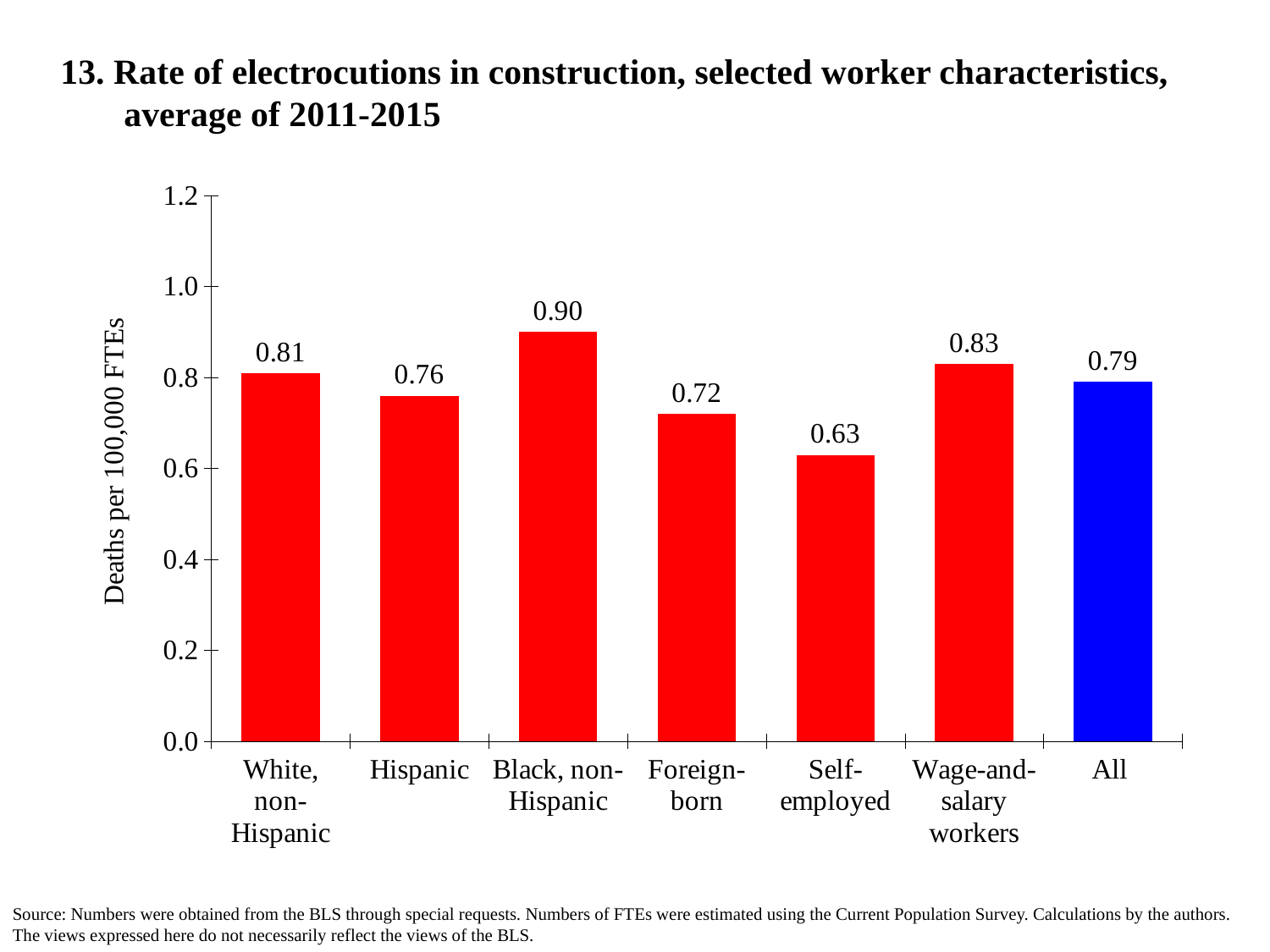
What is the difference between the rates for Black, non-Hispanic and Self-employed workers? 0.27 What is the rate of electrocutions for Self-employed workers? 0.63 What is the value shown for the All category? 0.79 What is the difference between the rates for White, non-Hispanic and Hispanic workers? 0.05 What kind of chart is shown on the slide? Bar chart How many worker categories are shown in the chart? 7 Which worker category has the highest rate of electrocutions? Black, non-Hispanic What is the value shown for Wage-and-salary workers? 0.83 What is the label of the vertical axis? Deaths per 100,000 FTEs Which is larger, the rate for Foreign-born workers or the rate for Wage-and-salary workers? Wage-and-salary workers Which worker category has the lowest rate of electrocutions? Self-employed What is the rate of electrocutions for Black, non-Hispanic workers? 0.90